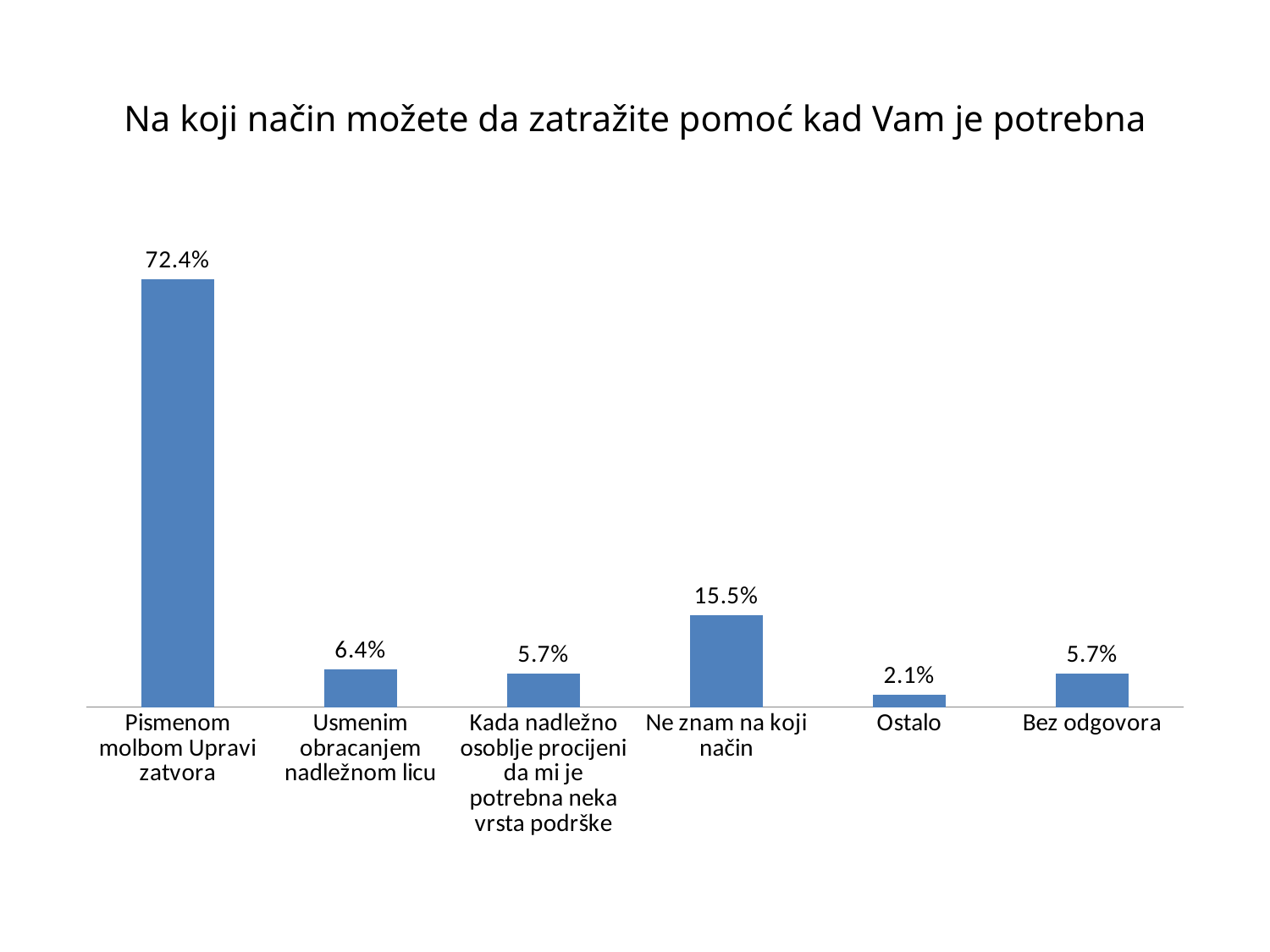
What is the difference between the values for "Pismenom molbom Upravi zatvora" and "Ne znam na koji način"? 56.9% Which category has the lowest value? Ostalo What is the value for "Ostalo"? 2.1% What is the value for "Pismenom molbom Upravi zatvora"? 72.4% What is the title of the chart? Na koji način možete da zatražite pomoć kad Vam je potrebna Which category has the highest value? Pismenom molbom Upravi zatvora What kind of chart is shown on the slide? Bar chart What is the value for "Ne znam na koji način"? 15.5% What is the value for "Usmenim obracanjem nadležnom licu"? 6.4% How many categories are shown in the chart? 6 What is the difference between the values for "Usmenim obracanjem nadležnom licu" and "Bez odgovora"? 0.7% Which is larger, the value for "Ne znam na koji način" or the value for "Usmenim obracanjem nadležnom licu"? Ne znam na koji način